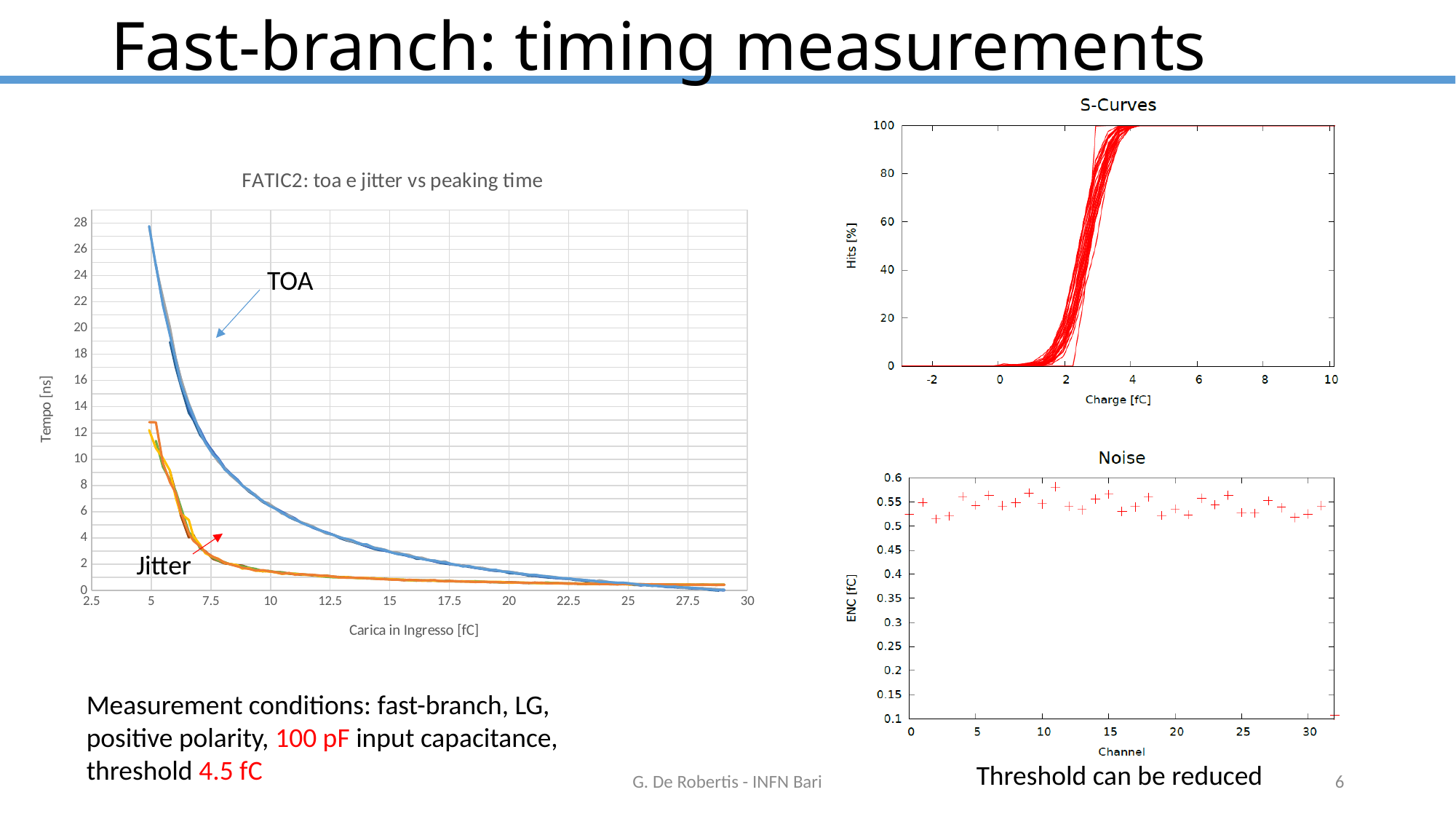
What is the x-axis label of the 'FATIC2: toa e jitter vs peaking time' chart? Carica in Ingresso [fC] In the 'S-Curves' chart, do the Hits [%] values rise or fall as the charge increases? rise What kind of chart is the 'Noise' chart? scatter plot In the 'FATIC2: toa e jitter vs peaking time' chart, which curve is higher at 10 fC, TOA or Jitter? TOA In the 'FATIC2: toa e jitter vs peaking time' chart, is the Jitter value at 5 fC greater or less than 14 ns? less What is the x-axis label of the 'S-Curves' chart? Charge [fC] In the 'Noise' chart, is the ENC value for channel 10 greater or less than 0.45 fC? greater In the 'FATIC2: toa e jitter vs peaking time' chart, do the TOA values rise or fall as the input charge increases? fall What kind of chart is the 'FATIC2: toa e jitter vs peaking time' chart? line chart What is the y-axis label of the 'Noise' chart? ENC [fC]